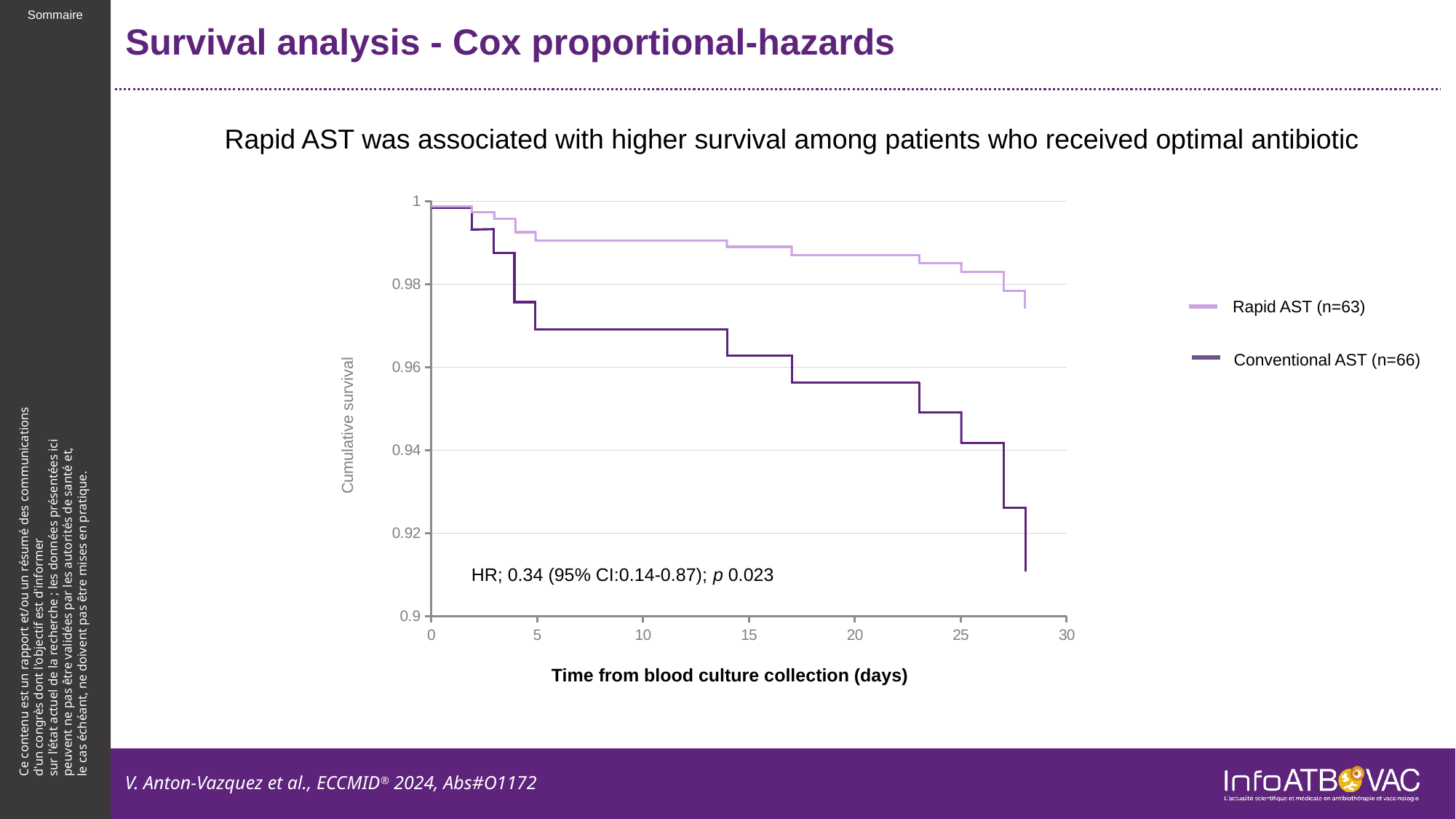
How many series does the legend list? 2 Is the cumulative survival for Conventional AST at day 28 greater or less than 0.92? less Do the cumulative survival values rise or fall as time increases along the x axis? fall Is the cumulative survival for Conventional AST at day 10 greater or less than 0.96? greater What kind of chart is shown on the slide? line chart What is the title of the x axis? Time from blood culture collection (days) Which series ends with the lower cumulative survival at the end of follow-up? Conventional AST Is the cumulative survival for Rapid AST at day 15 greater or less than 0.98? greater Which two series are listed in the legend? Rapid AST (n=63) and Conventional AST (n=66) At day 25, which series has the higher cumulative survival, Rapid AST or Conventional AST? Rapid AST